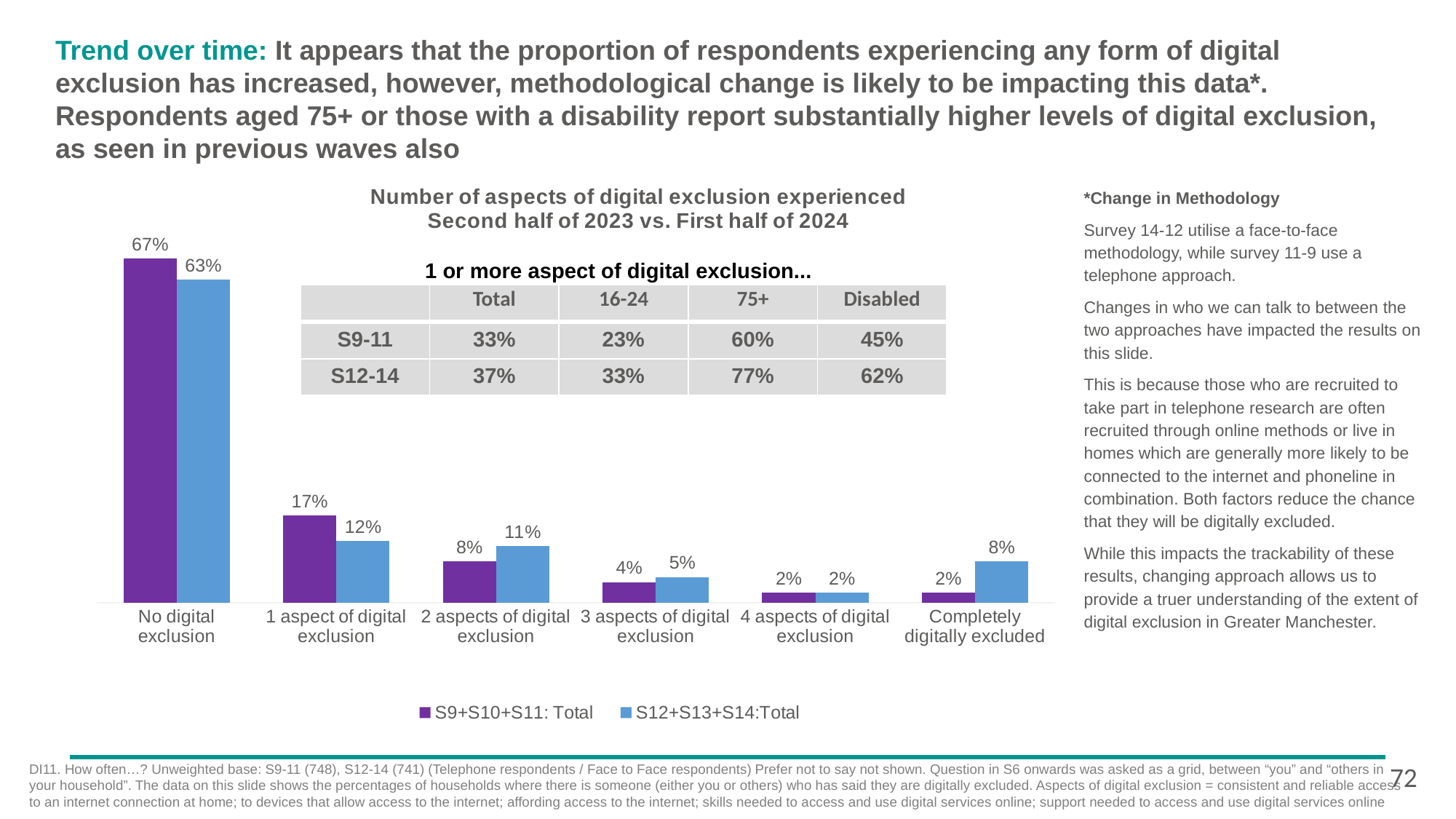
What is the title of the chart? Number of aspects of digital exclusion experienced Second half of 2023 vs. First half of 2024 What is the value for 'Completely digitally excluded' in the S12+S13+S14:Total series? 8% What is the difference between the S9+S10+S11: Total and S12+S13+S14:Total values for 'No digital exclusion'? 4 percentage points What is the value for 'No digital exclusion' in the S9+S10+S11: Total series? 67% Which category has the lowest value in the S9+S10+S11: Total series? 4 aspects of digital exclusion and Completely digitally excluded (both 2%) How many categories are shown on the x axis of the chart? 6 Which colour represents the S12+S13+S14:Total series in the chart? Blue What is the value for '1 aspect of digital exclusion' in the S12+S13+S14:Total series? 12% How many series does the chart legend list? 2 What kind of chart is shown on the slide? Bar chart For '2 aspects of digital exclusion', which series has the larger value: S9+S10+S11: Total or S12+S13+S14:Total? S12+S13+S14:Total Which category has the highest value in the S12+S13+S14:Total series? No digital exclusion